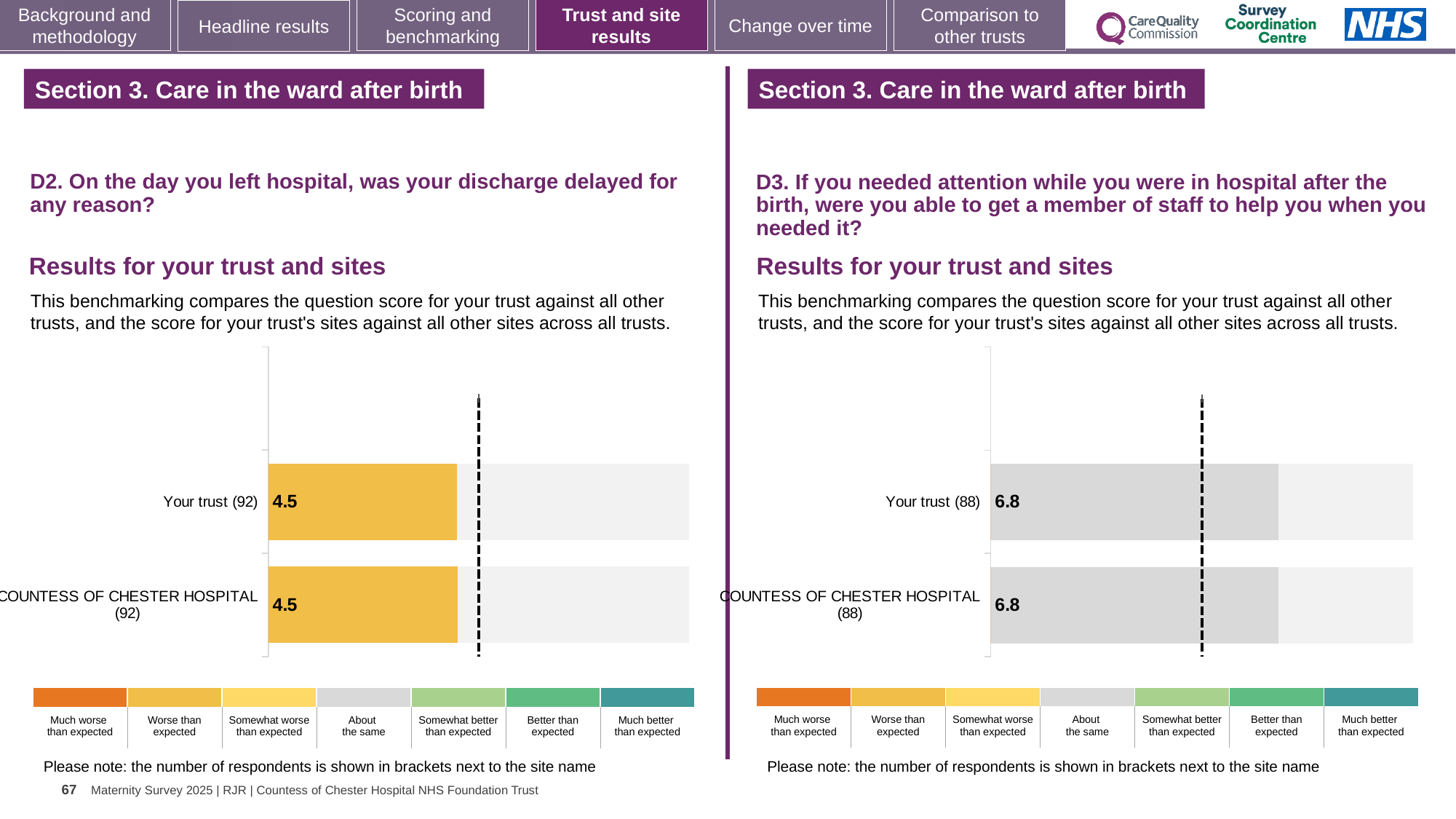
On the left chart (D2, discharge delayed), what is the score for Your trust? 4.5 What kind of chart is used on the left side of the slide (D2)? Bar chart How many bars are plotted on the right chart (D3)? 2 How many bars are plotted on the left chart (D2)? 2 On the left chart (D2), how many respondents are shown in brackets next to Your trust? 92 On the right chart (D3), how many respondents are shown in brackets next to COUNTESS OF CHESTER HOSPITAL? 88 On the right chart (D3, able to get a member of staff to help), what is the score for COUNTESS OF CHESTER HOSPITAL? 6.8 On the right chart (D3), which benchmark category does the grey colour of the bars correspond to in the legend? About the same On the left chart (D2, discharge delayed), what is the score for COUNTESS OF CHESTER HOSPITAL? 4.5 On the right chart (D3), what is the difference between the score for Your trust and the score for COUNTESS OF CHESTER HOSPITAL? 0.0 On the right chart (D3, able to get a member of staff to help), what is the score for Your trust? 6.8 On the left chart (D2), what is the difference between the score for Your trust and the score for COUNTESS OF CHESTER HOSPITAL? 0.0